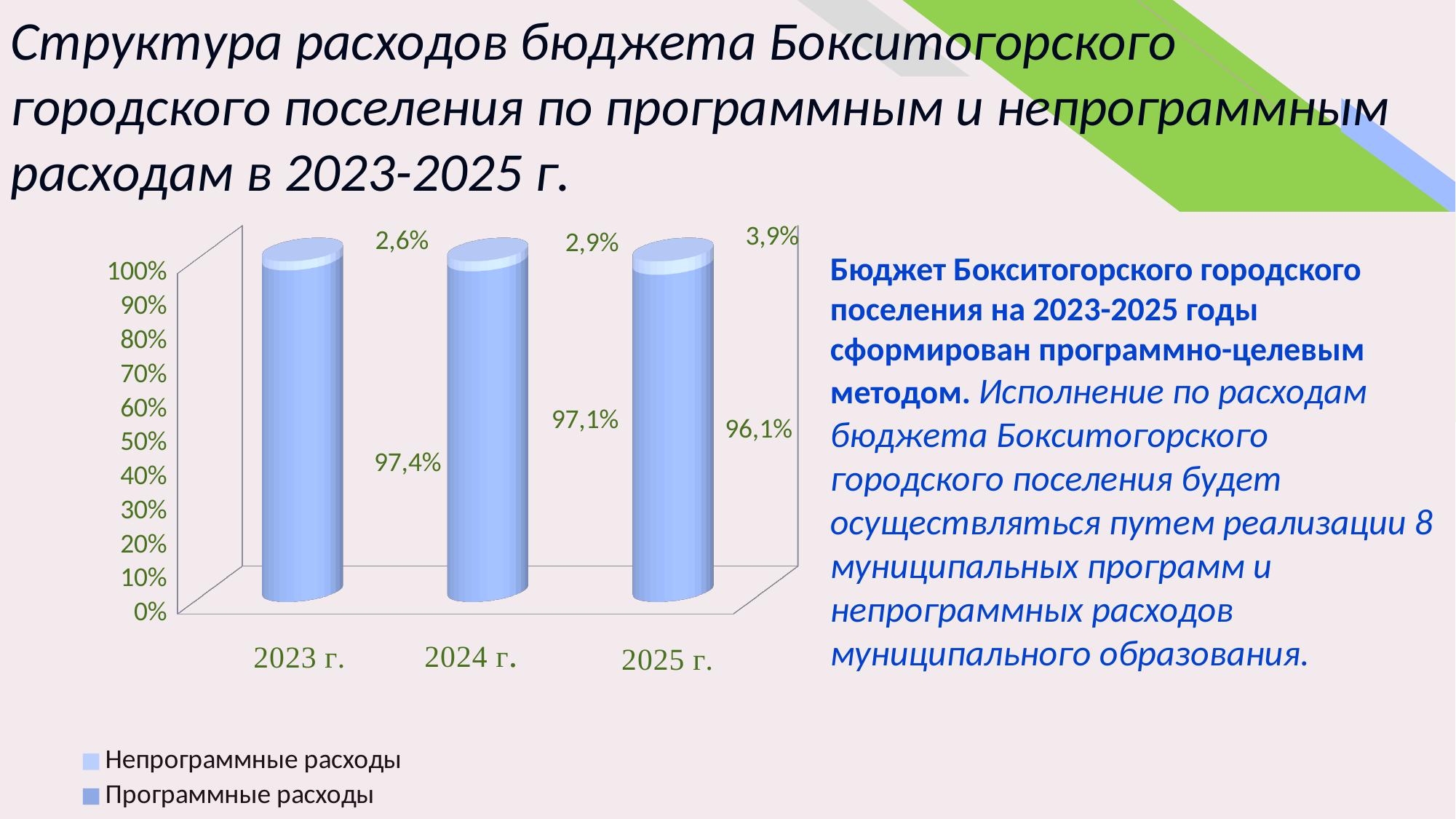
What is the value for Программные расходы in 2025 г.? 96,1% In which year is the share of Непрограммные расходы highest? 2025 г. In which year is the share of Программные расходы lowest? 2025 г. Does the share of Программные расходы rise or fall from 2023 г. to 2025 г.? Fall What is the value for Непрограммные расходы in 2024 г.? 2,9% What is the difference between the Непрограммные расходы values for 2025 г. and 2023 г.? 1,3% What kind of chart is shown on the slide? Stacked bar chart How many years are shown on the x axis of the chart? 3 How many series does the chart legend list? 2 Which is larger: Программные расходы in 2023 г. or in 2024 г.? 2023 г. What is the value for Программные расходы in 2023 г.? 97,4% What is the value for Непрограммные расходы in 2025 г.? 3,9%